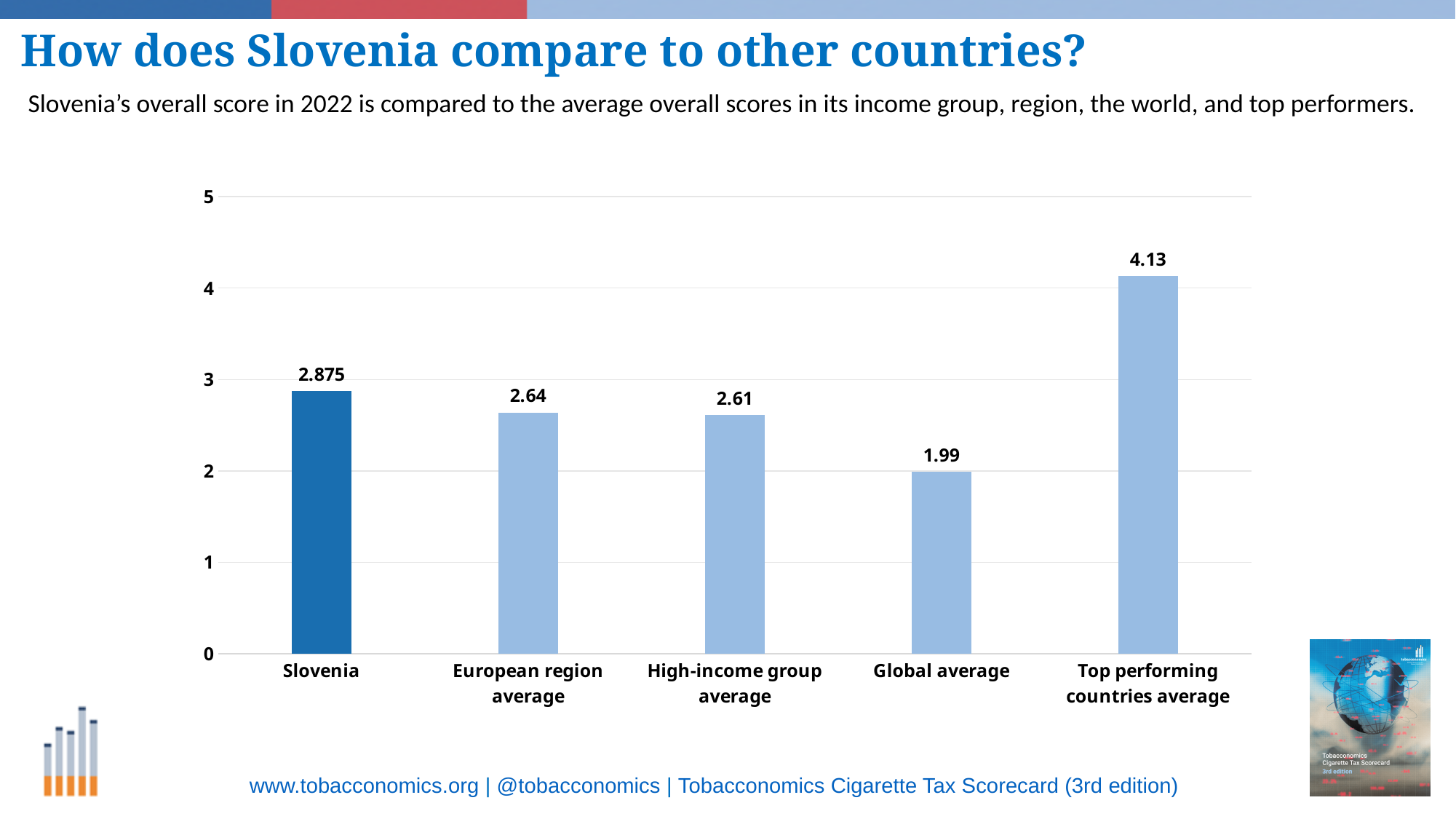
What kind of chart is shown on the slide? Bar chart What is the overall score shown for Slovenia? 2.875 Which is larger, Slovenia's score or the European region average? Slovenia Which category has the highest value? Top performing countries average What is the value shown for the Global average? 1.99 What is the value shown for the Top performing countries average? 4.13 What is the difference between Slovenia's score and the Global average? 0.885 What is the difference between the Top performing countries average and Slovenia's score? 1.255 Which category has the lowest value? Global average What is the value shown for the High-income group average? 2.61 How many categories are shown on the chart? 5 Which bar is shown in a darker blue than the others? Slovenia